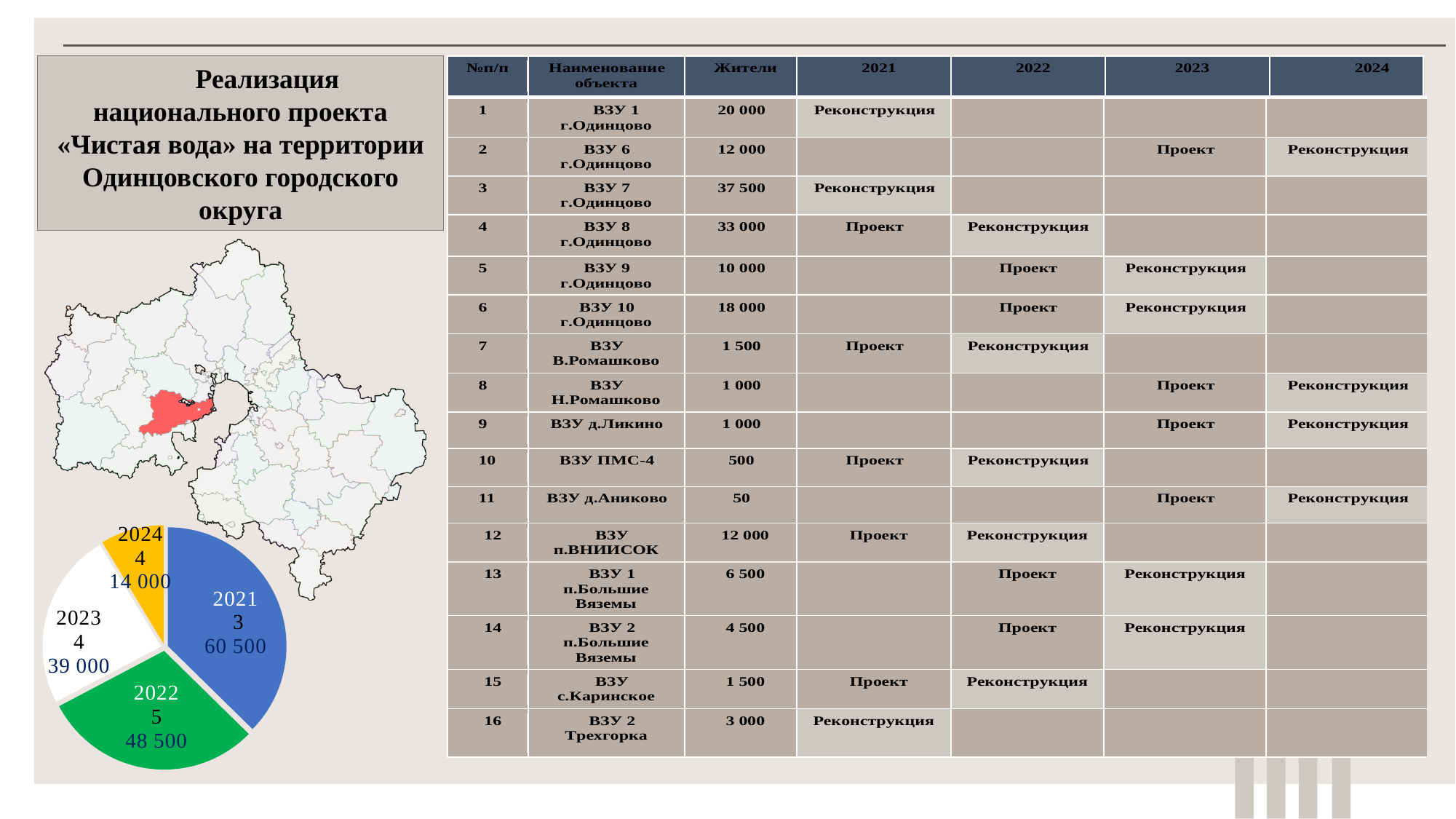
In the pie chart, what is the difference between the residents values for 2021 and 2022? 12 000 In the pie chart, what is the difference between the residents values for 2023 and 2024? 25 000 In the pie chart, what residents value is shown in the label for the 2021 slice? 60 500 Which year has the smallest slice in the pie chart? 2024 In the pie chart, what residents value is shown in the label for the 2024 slice? 14 000 In the pie chart, which slice has the larger residents value, 2022 or 2023? 2022 How many slices does the pie chart have? 4 What colour is the 2022 slice in the pie chart? green In the pie chart, what residents value is shown in the label for the 2022 slice? 48 500 Which year has the largest slice in the pie chart? 2021 What kind of chart is shown at the bottom left of the slide? pie chart In the pie chart, what count is shown in the label for the 2022 slice (the number between the year and the residents value)? 5